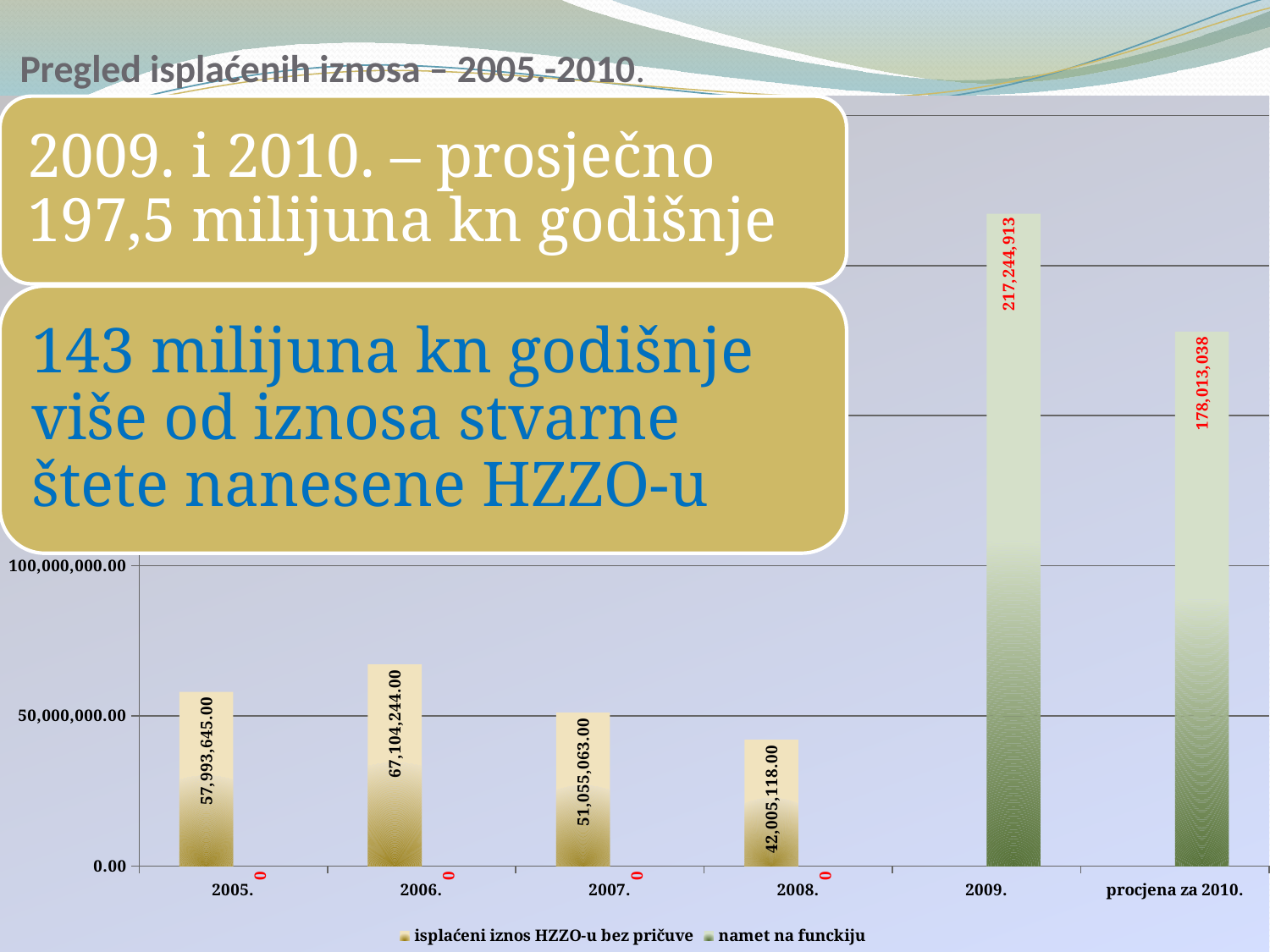
How many categories are shown on the x axis of the chart? 6 What is the difference between the values for 2006. and 2007.? 16,049,181.00 Which year has the tallest bar in the chart? 2009. What value is shown for 2008. in the chart? 42,005,118.00 What type of chart is shown on the slide? Bar chart What value is labelled on the bar for 2009.? 217,244,913 What value is labelled on the bar for 'procjena za 2010.'? 178,013,038 Which is larger, the value for 2005. or the value for 2007.? 2005. What value is shown for 2006. in the chart? 67,104,244.00 Which year has the lowest labelled bar value in the chart? 2008. How many series does the chart legend list? 2 What value is shown for 2005. in the chart? 57,993,645.00